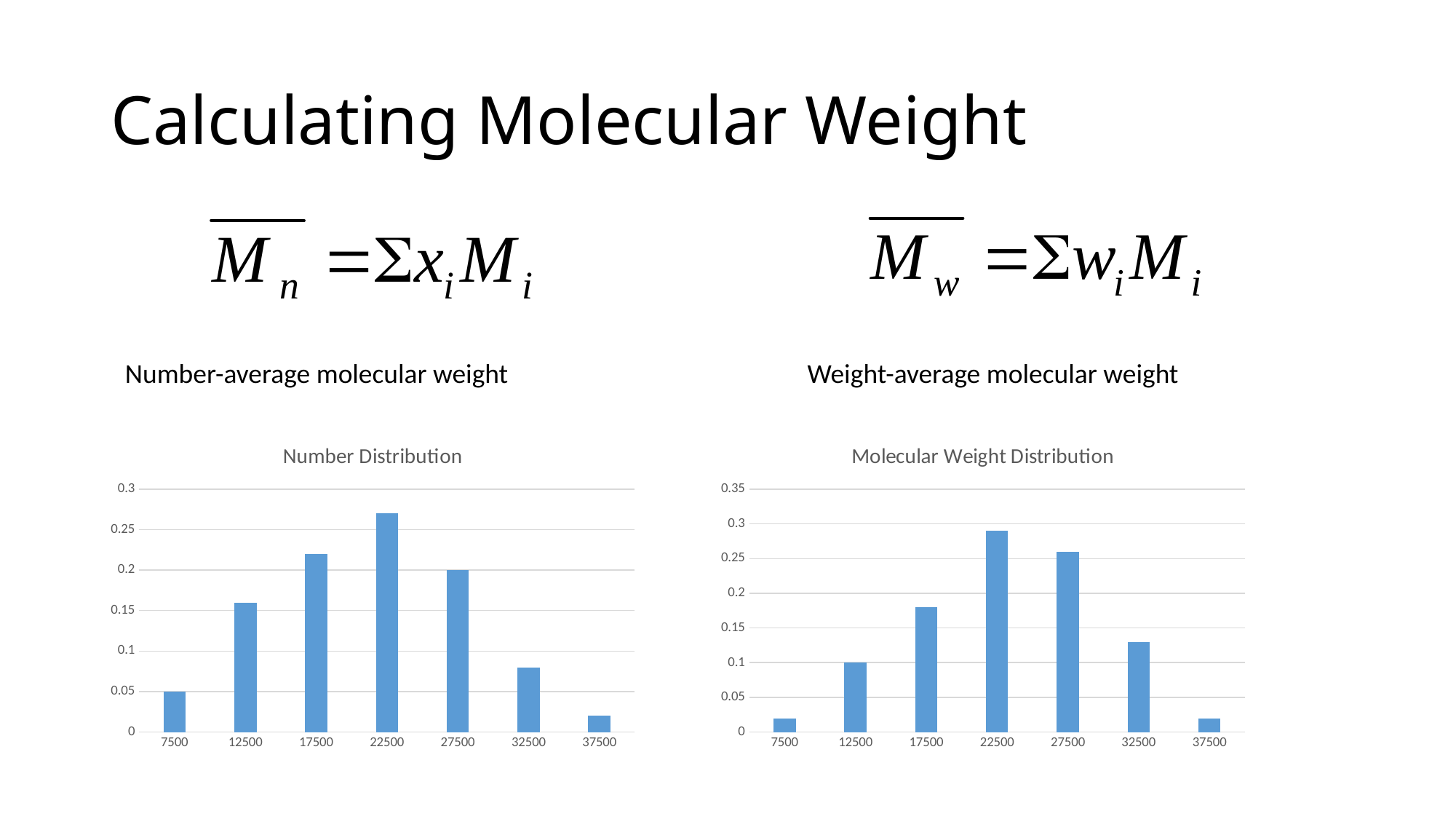
How many categories are shown on the x axis of the Number Distribution chart? 7 In the Number Distribution chart, which category has the highest bar? 22500 In the Molecular Weight Distribution chart, which category has the highest bar? 22500 In the Molecular Weight Distribution chart, which is larger, the value for 17500 or the value for 27500? 27500 In the Molecular Weight Distribution chart, what is the value for 12500? 0.1 What kind of chart is the Molecular Weight Distribution chart? Bar chart In the Number Distribution chart, is the value for 17500 greater or less than 0.2? greater What is the title of the chart on the left side of the slide? Number Distribution In the Number Distribution chart, what is the value for 7500? 0.05 In the Molecular Weight Distribution chart, is the value for 32500 greater or less than 0.15? less In the Number Distribution chart, what is the value for 27500? 0.2 In the Number Distribution chart, which category has the lowest bar? 37500